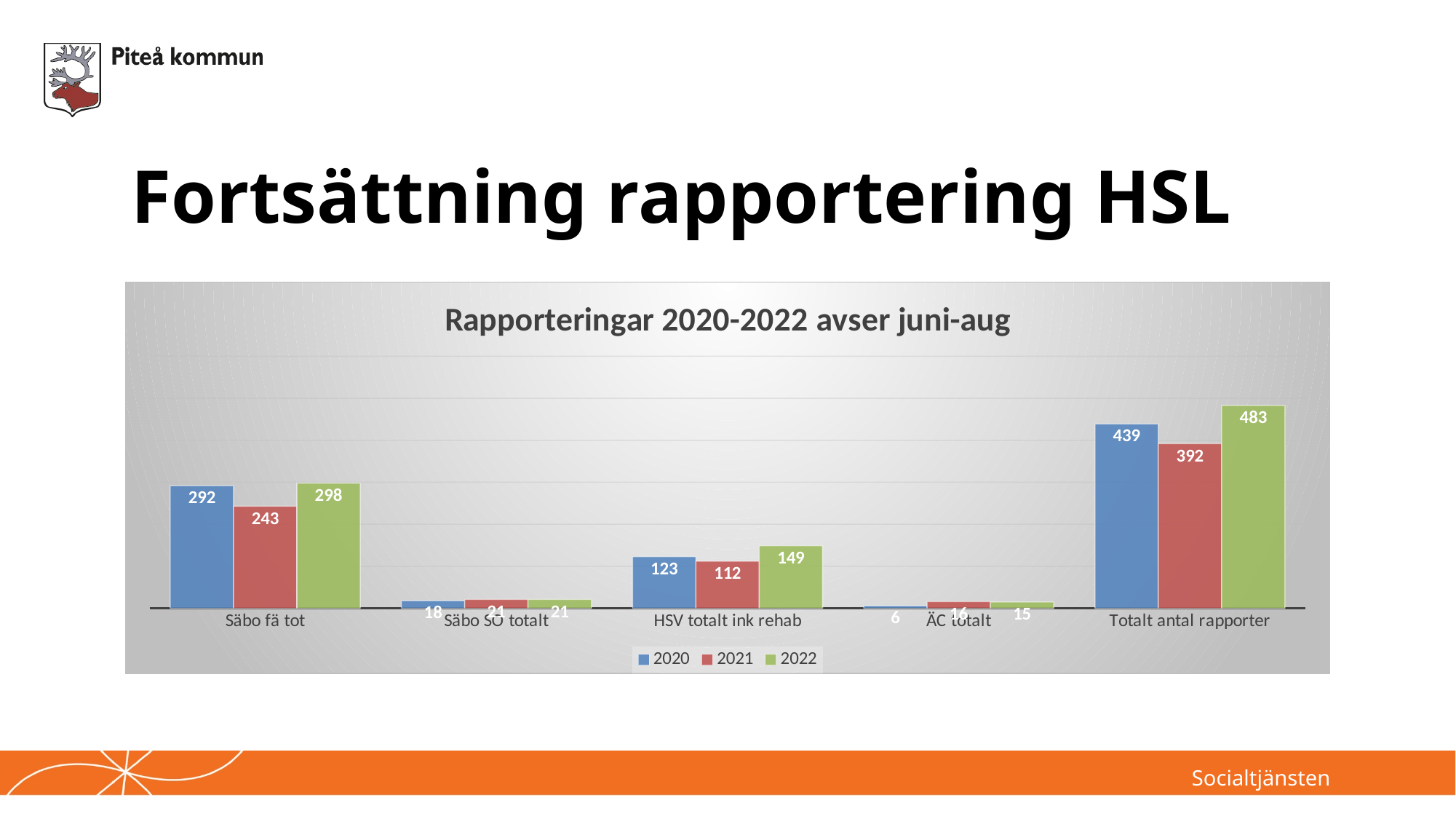
What is the difference between the 2022 and 2021 values for HSV totalt ink rehab? 37 How many categories are shown on the x axis? 5 What is the difference between the 2022 and 2020 values for Totalt antal rapporter? 44 What is the value for 2021 in the Totalt antal rapporter category? 392 What is the value for 2022 in the Säbo fä tot category? 298 Which year has the highest value in the Totalt antal rapporter category? 2022 What kind of chart is shown on the slide? Bar chart What is the title of the chart? Rapporteringar 2020-2022 avser juni-aug What is the value for 2020 in the HSV totalt ink rehab category? 123 Which year has the lowest value in the Säbo fä tot category? 2021 Which is larger for Säbo fä tot: the 2020 value or the 2021 value? 2020 How many series does the legend list? 3